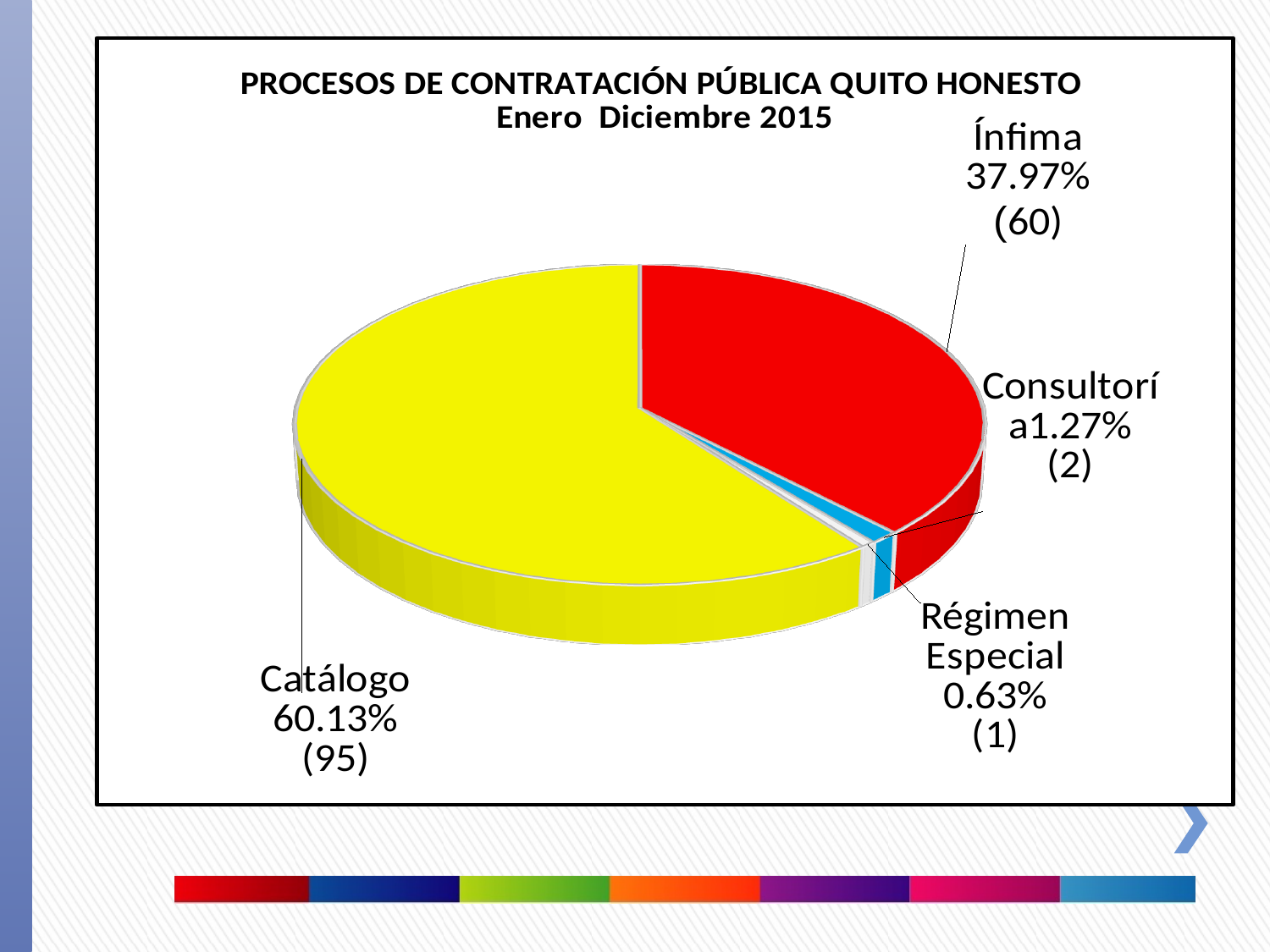
Which category has the smallest slice of the pie? Régimen Especial What is the difference in number of processes between Catálogo and Ínfima? 35 Which category has the largest slice of the pie? Catálogo What percentage share does Régimen Especial have? 0.63% What percentage share does Catálogo have? 60.13% What kind of chart is shown on the slide? Pie chart How many processes are shown for Ínfima? 60 Which is larger, the share for Ínfima or the share for Consultoría? Ínfima What is the total number of processes across all categories? 158 How many processes are shown for Consultoría? 2 What colour is the Catálogo slice? Yellow How many categories are shown in the pie chart? 4